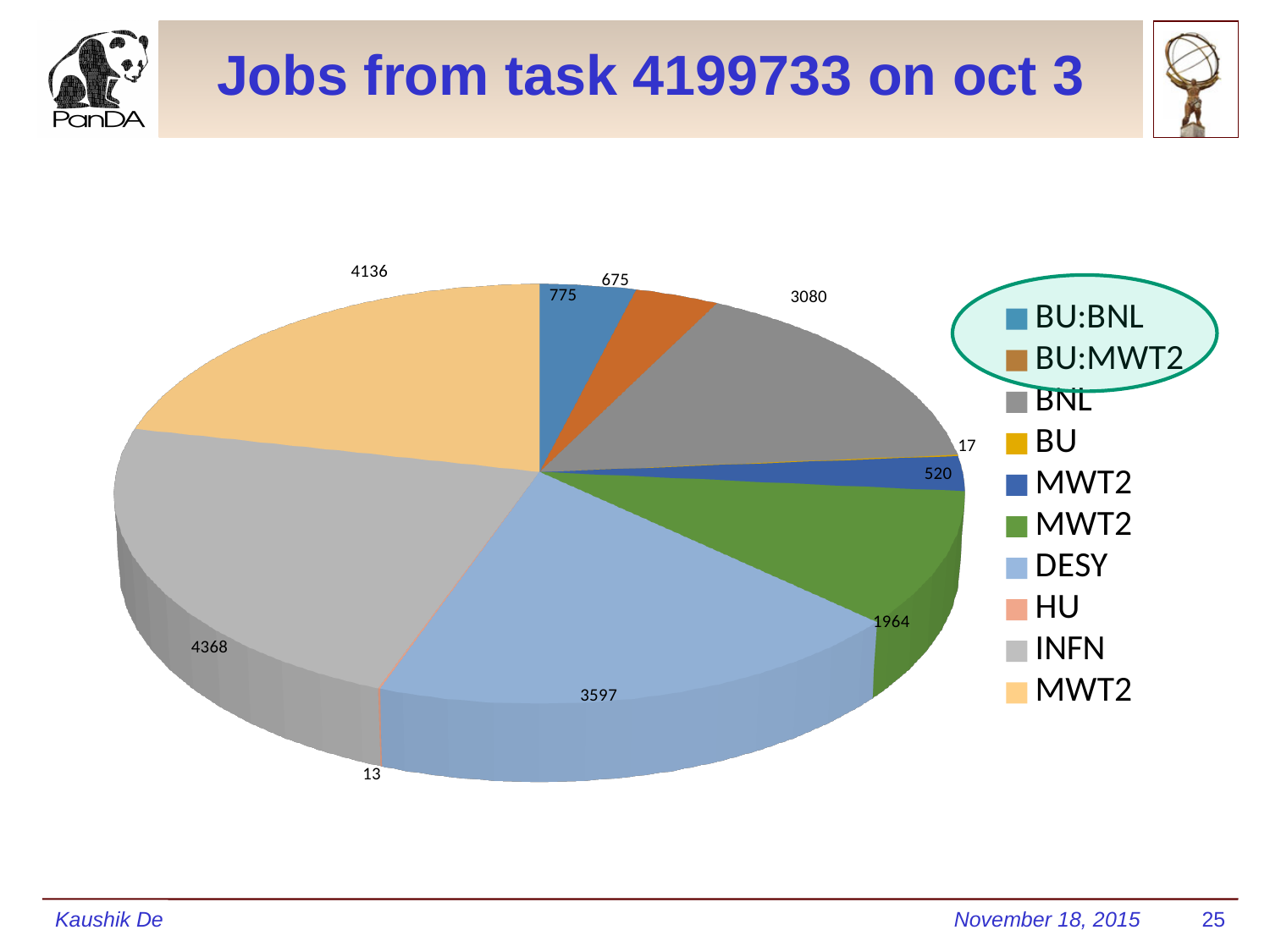
What is the value of the INFN slice? 4368 What is the value of the BU:BNL slice? 775 What is the value of the BNL slice? 3080 What is the value of the DESY slice? 3597 What is the difference between the INFN and DESY values? 771 Which category has the largest slice of the pie? INFN What is the title of the slide containing the chart? Jobs from task 4199733 on oct 3 Which is larger, the DESY slice or the BNL slice? DESY Which category has the smallest slice of the pie? HU What type of chart is shown on the slide? Pie chart What is the value of the HU slice? 13 How many entries does the legend list? 10